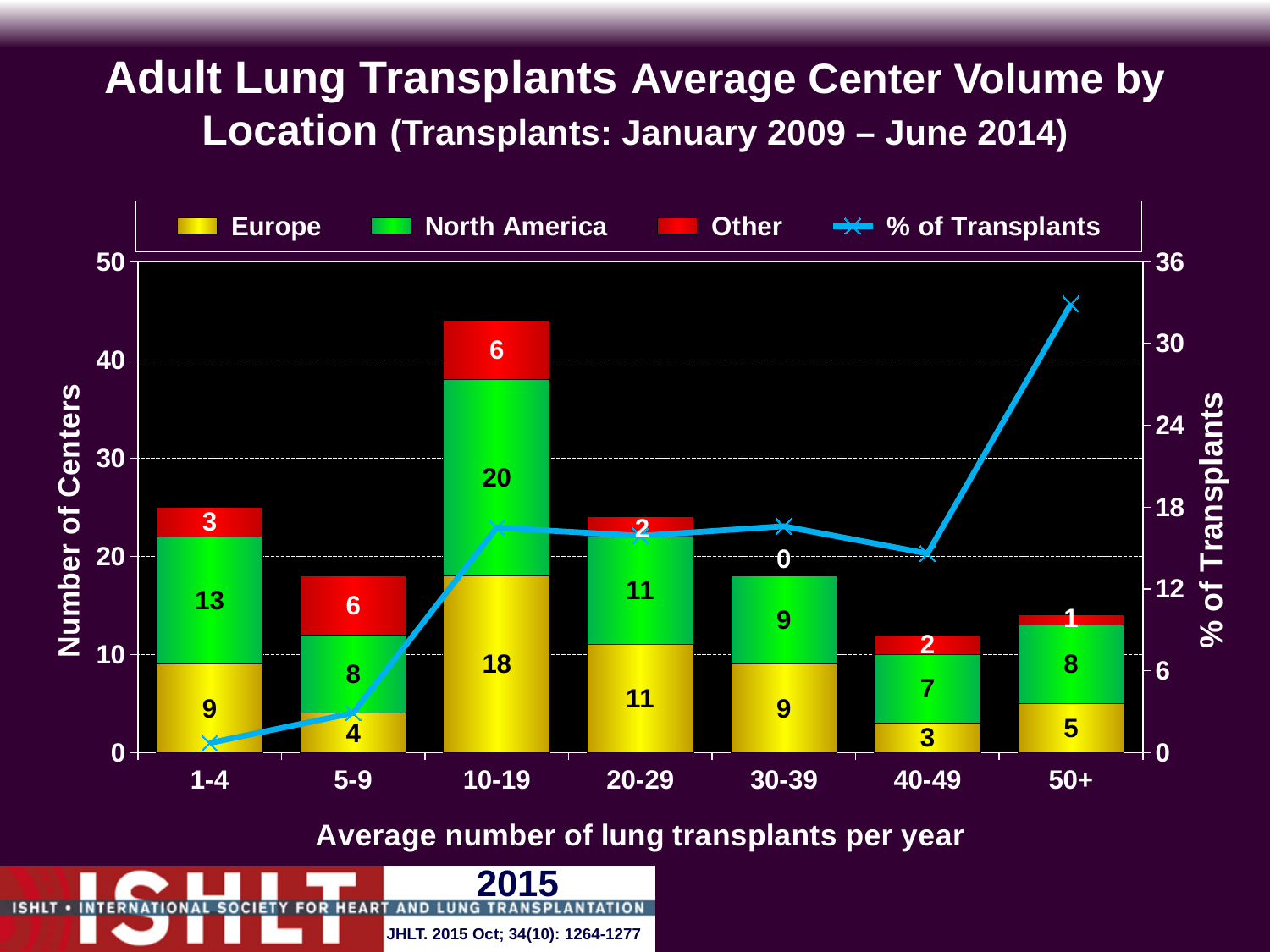
What is the Europe value for the 10-19 category? 18 In the 1-4 category, how much larger is the North America value than the Europe value? 4 What is the total number of centers in the stacked bar for the 10-19 category? 44 Which category has the highest North America value? 10-19 What is the North America value for the 40-49 category? 7 Which is larger: the Europe value for 20-29 or the Europe value for 50+? 20-29 How many series does the legend list? 4 How many categories are shown on the x axis? 7 What is the Other value for the 30-39 category? 0 What kind of chart is used to show the number of centers? bar chart Is the % of Transplants value for the 50+ category greater or less than 30? greater Which category has the lowest Europe value? 40-49